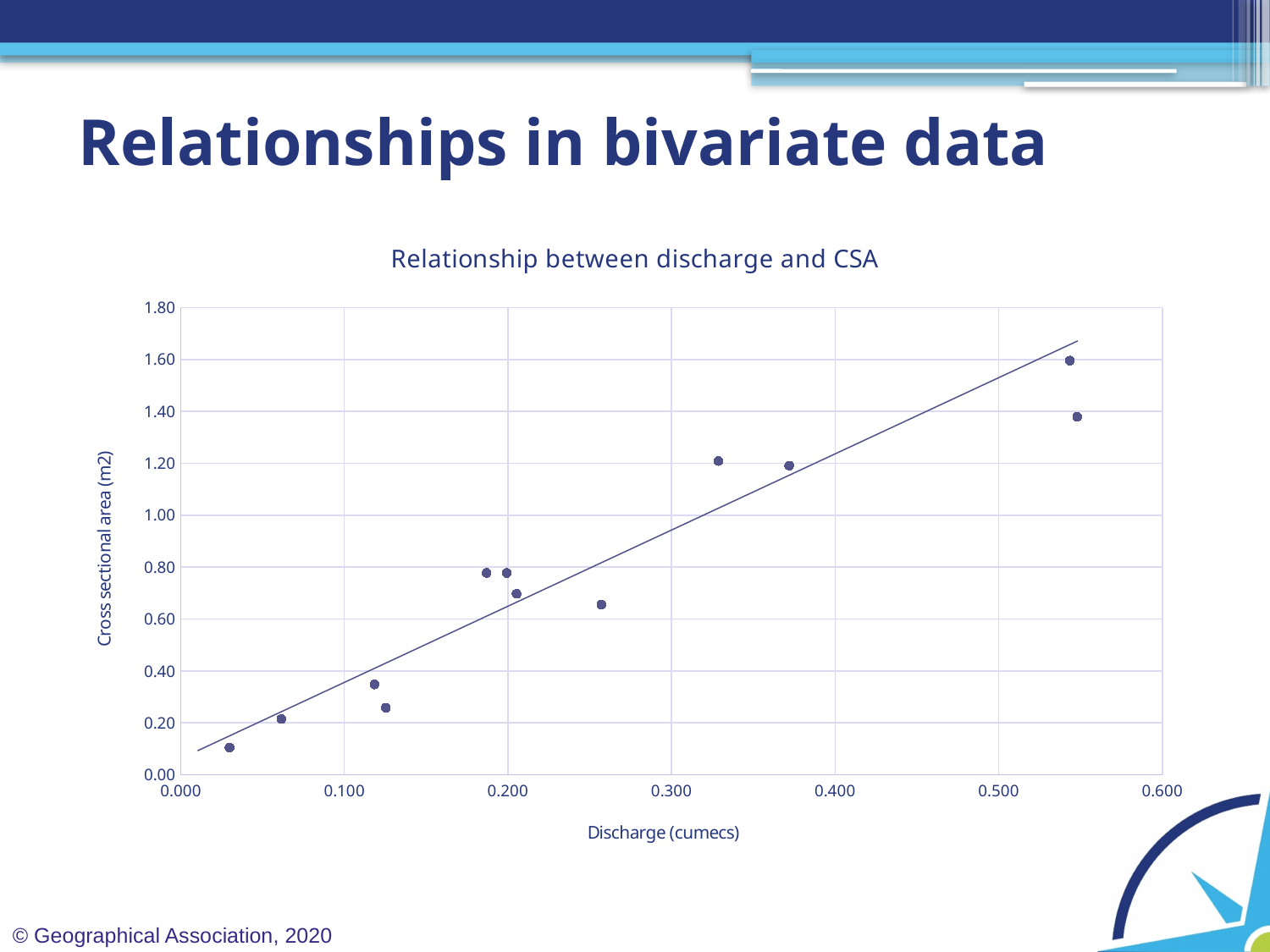
Is the cross sectional area of the highest plotted point greater or less than 1.40? greater What is the title of the chart? Relationship between discharge and CSA Is the discharge of the point with the largest cross sectional area greater or less than 0.500? greater How many plotted points have a cross sectional area below 0.40? 4 As discharge increases along the x axis, does cross sectional area generally rise or fall? Rise Is the cross sectional area of the lowest plotted point greater or less than 0.20? less What is the label of the x axis? Discharge (cumecs) How many data points are plotted on the chart? 12 How many plotted points have a cross sectional area above 1.00? 4 What kind of chart is shown on the slide? Scatter chart